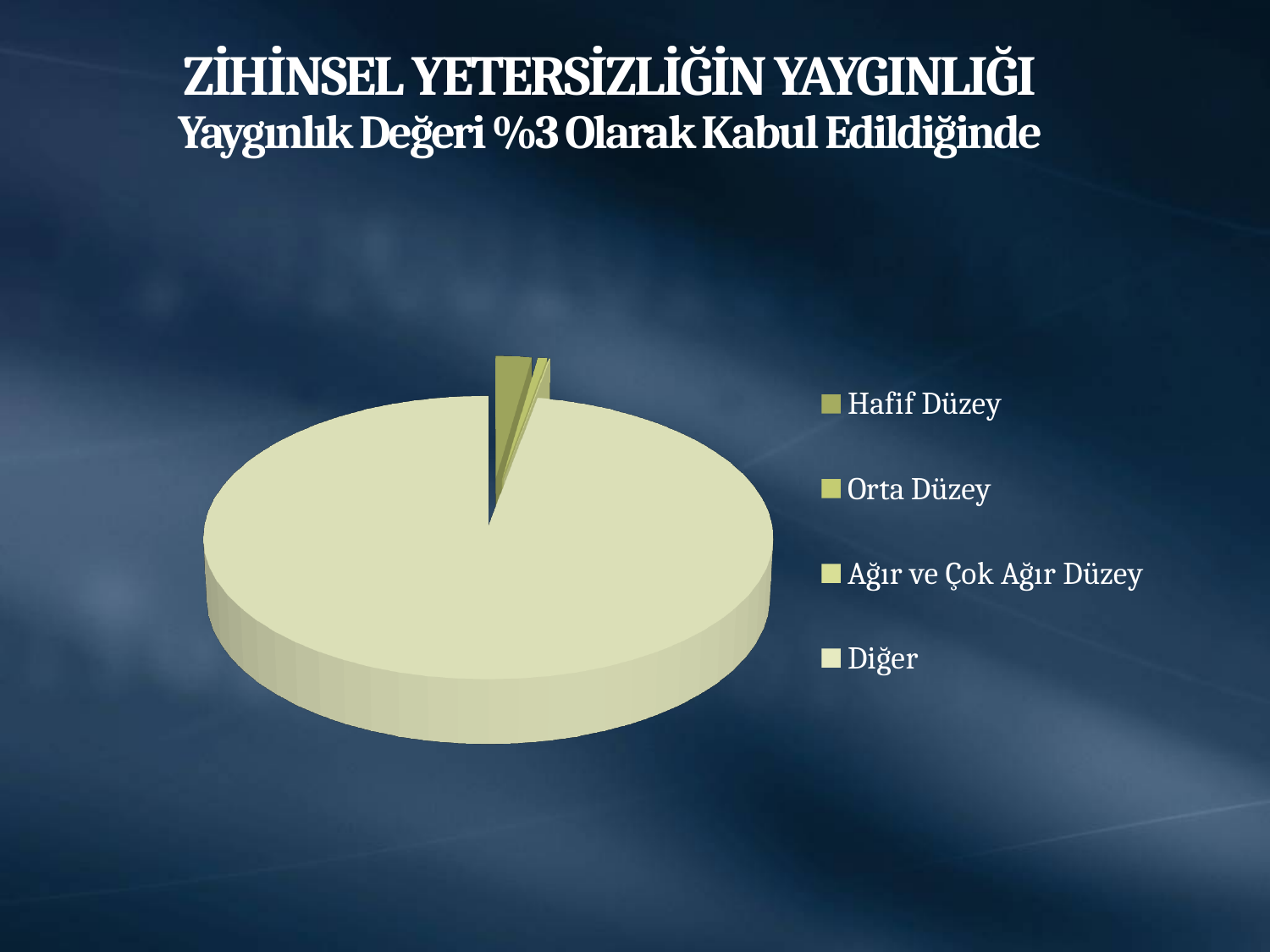
Which slice is larger, Hafif Düzey or Orta Düzey? Hafif Düzey How many categories does the legend of the pie chart list? 4 Which slice is larger, Diğer or Hafif Düzey? Diğer Which slice is larger, Hafif Düzey or Ağır ve Çok Ağır Düzey? Hafif Düzey Does the Diğer slice take up more or less than half of the pie chart? more What kind of chart is shown on the slide? pie chart What is the first category listed in the legend of the pie chart? Hafif Düzey What is the main title of the slide containing the pie chart? ZİHİNSEL YETERSİZLİĞİN YAYGINLIĞI Which category has the largest slice of the pie chart? Diğer